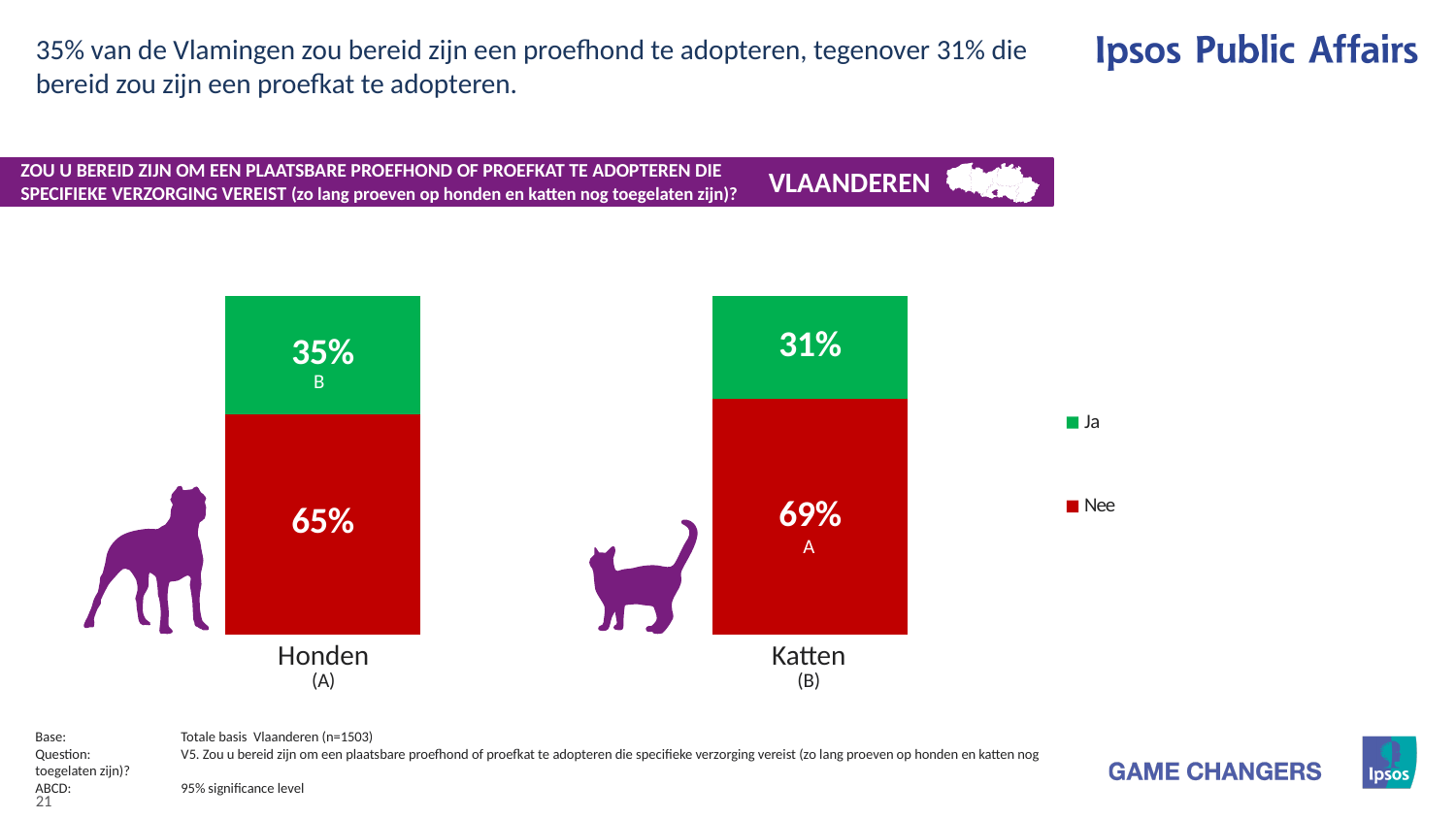
Which category has the higher "Ja" share, Honden or Katten? Honden What is the "Ja" value for Katten? 31% What percentage of respondents answered "Ja" for Honden? 35% What percentage of respondents answered "Nee" for Katten? 69% Which colour represents "Nee" in the legend? Red What is the "Nee" value for Honden? 65% What kind of chart is shown on the slide? Stacked bar chart How many series does the legend list? 2 What is the difference between the "Ja" values for Honden and Katten? 4 percentage points How many categories are shown on the x axis? 2 Which category has the highest "Nee" value? Katten What is the difference between the "Nee" values for Katten and Honden? 4 percentage points